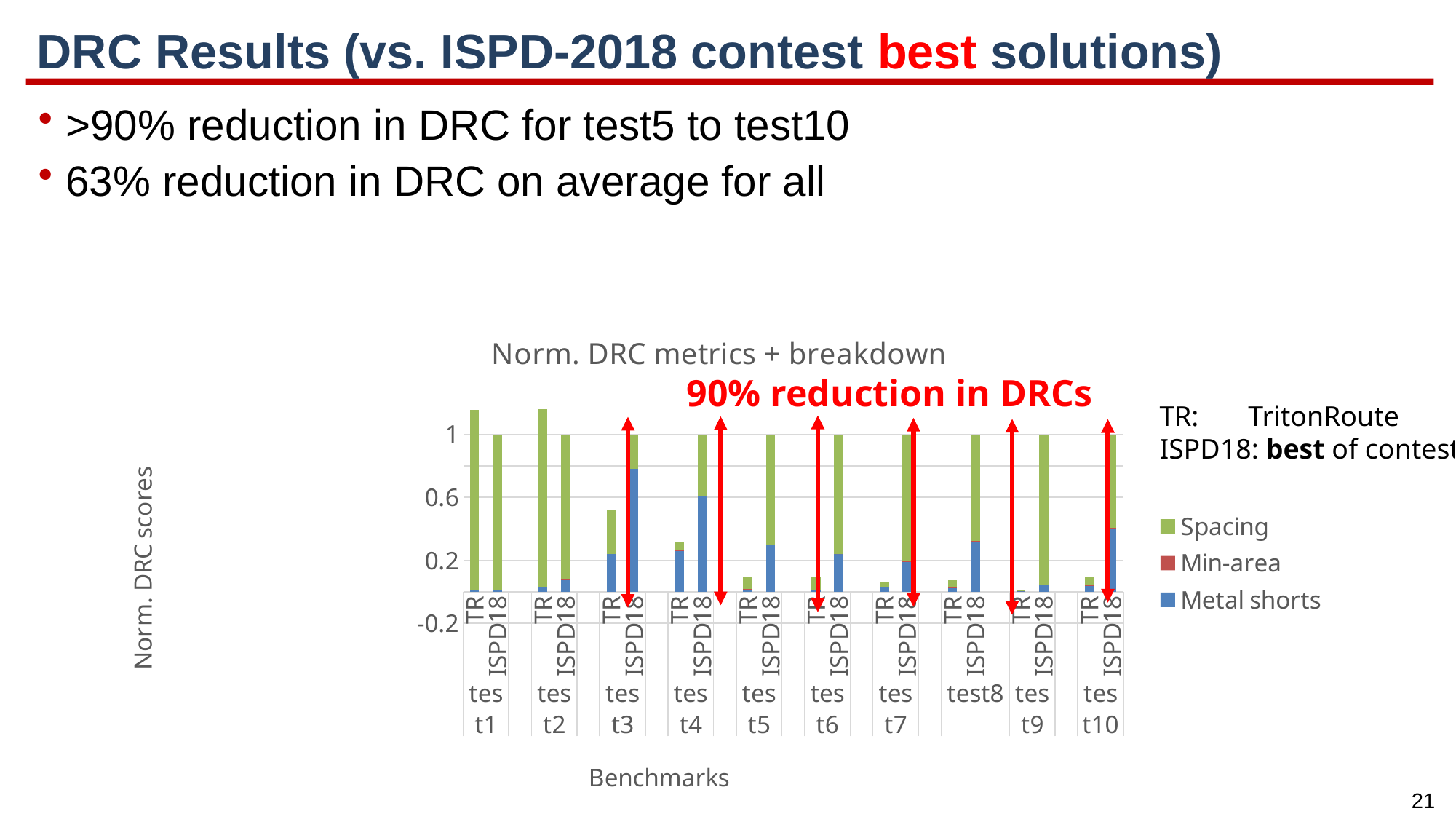
Is the total value of the TR bar for test3 greater or less than 0.6? less How many benchmarks are shown along the x axis of the chart? 10 Which bar is taller for test5, TR or ISPD18? ISPD18 Is the total value of the TR bar for test5 greater or less than 0.2? less Is the total value of the TR bar for test4 greater or less than 0.2? greater What is the label of the y axis of the chart? Norm. DRC scores How many series does the chart legend list? 3 What kind of chart is shown on the slide? Stacked bar chart Which benchmark has the lowest TR bar? test9 Which bar is taller for test1, TR or ISPD18? TR What is the title of the chart? Norm. DRC metrics + breakdown